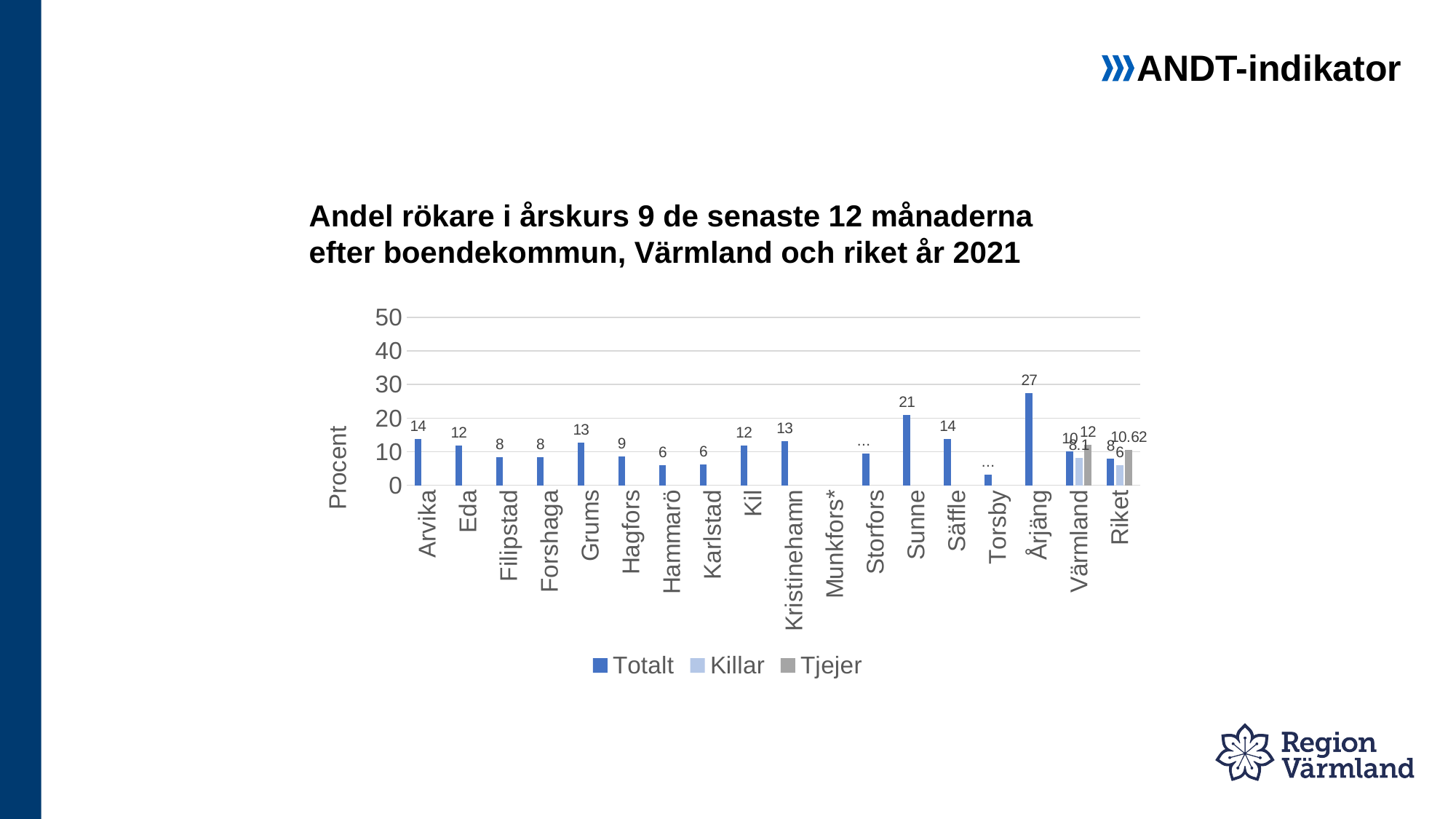
How many series does the legend list? 3 Which has a higher Totalt value, Sunne or Säffle? Sunne What is the Totalt value for Sunne? 21 Which municipality has the highest Totalt value? Årjäng What kind of chart is shown on the slide? Bar chart Is the Totalt value for Torsby greater or less than 10? less For Värmland, which is larger, the Killar value or the Tjejer value? Tjejer What is the difference between the Totalt values for Årjäng and Sunne? 6 What is the difference between the Tjejer and Killar values for Riket? 4.62 What is the Totalt value for Årjäng? 27 What is the Tjejer value for Riket? 10.62 What is the Killar value for Värmland? 8.1